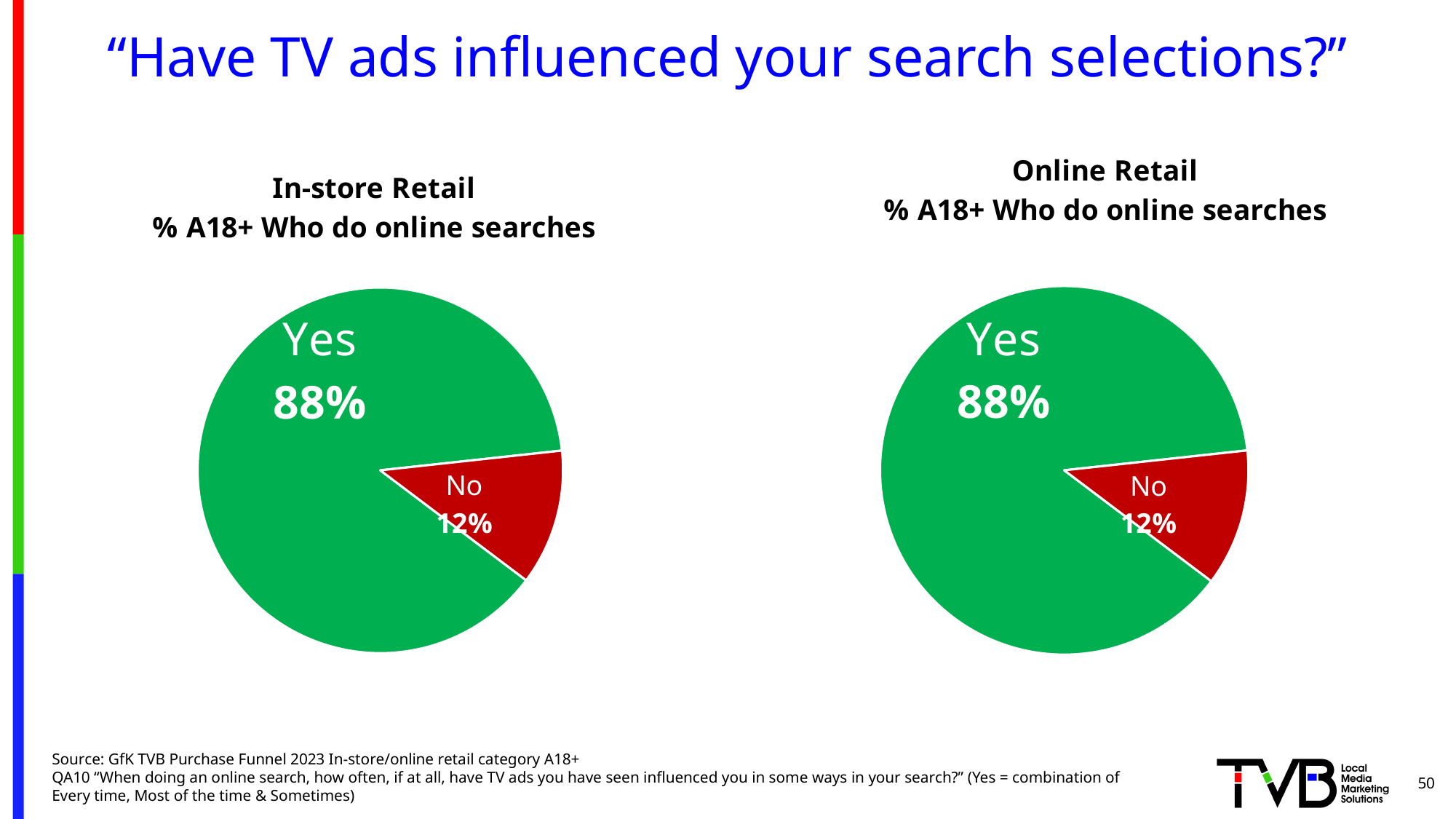
In the In-store Retail pie chart, what is the difference between the Yes and No percentages? 76 percentage points In the Online Retail pie chart, which is larger, the Yes slice or the No slice? Yes In the In-store Retail pie chart, what percentage answered Yes? 88% In the In-store Retail pie chart, what share of the pie does the No slice represent? 12% In the Online Retail pie chart, what percentage answered Yes? 88% In the Online Retail pie chart, which slice is the smallest? No In the In-store Retail pie chart, which slice is the largest? Yes In the In-store Retail pie chart, what percentage answered No? 12% In the Online Retail pie chart, what percentage answered No? 12% What colour is the Yes slice in the Online Retail pie chart? Green What kind of chart is used for the Online Retail data? Pie chart How many slices does the In-store Retail pie chart have? 2